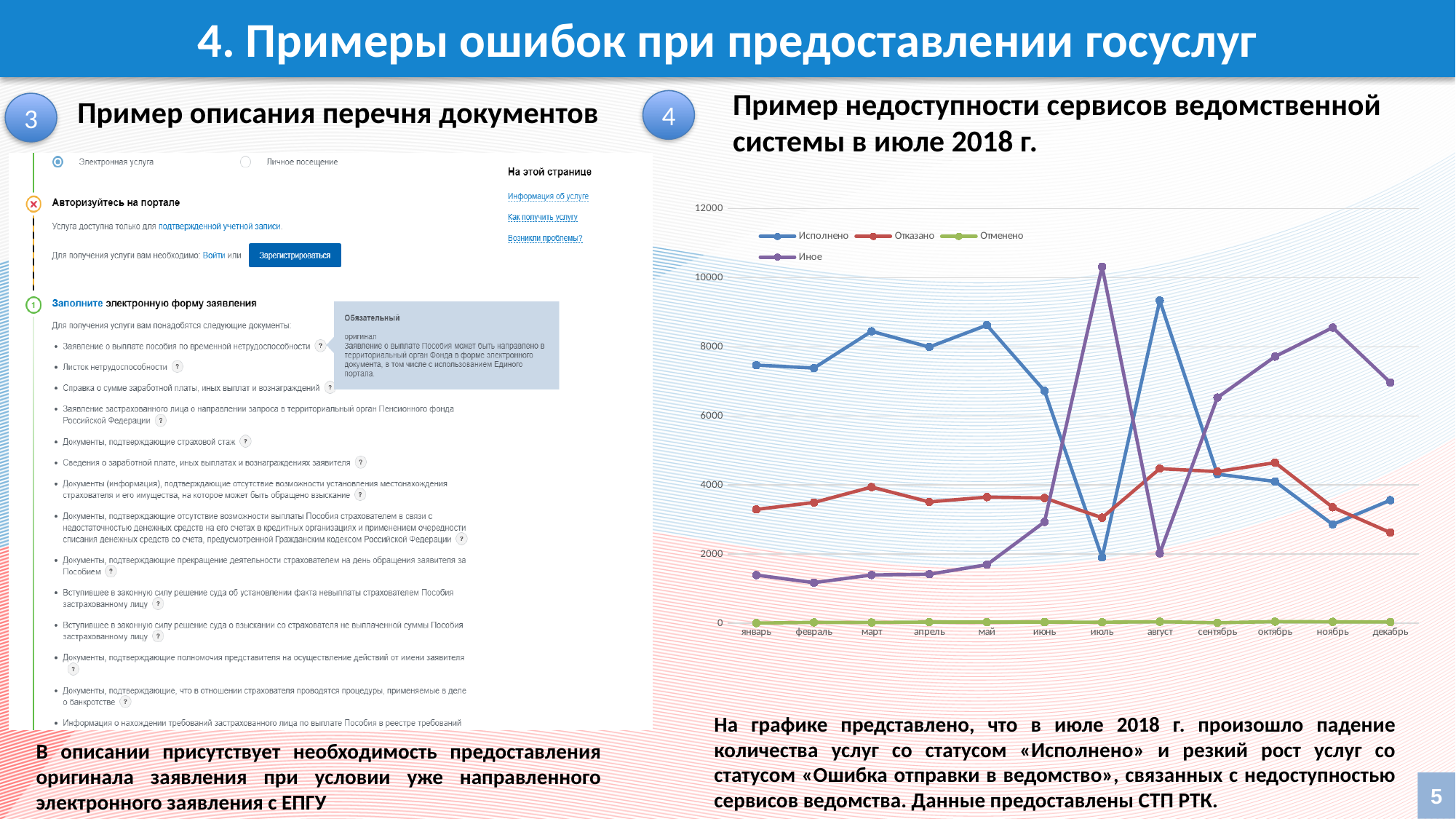
Does the Исполнено series rise or fall from сентябрь to ноябрь? fall How many months are shown along the x axis of the chart? 12 In июль, which series has the larger value, Исполнено or Иное? Иное How many series does the chart legend list? 4 In which month does the Исполнено series reach its lowest value? июль What kind of chart is shown on the slide? line chart Is the value for Отказано in октябрь greater or less than 4000? greater In which month does the Исполнено series reach its highest value? август In январь, which series has the larger value, Исполнено or Отказано? Исполнено Which series is drawn in green on the chart? Отменено Is the value for Исполнено in август greater or less than 8000? greater In which month does the Иное series reach its highest value? июль